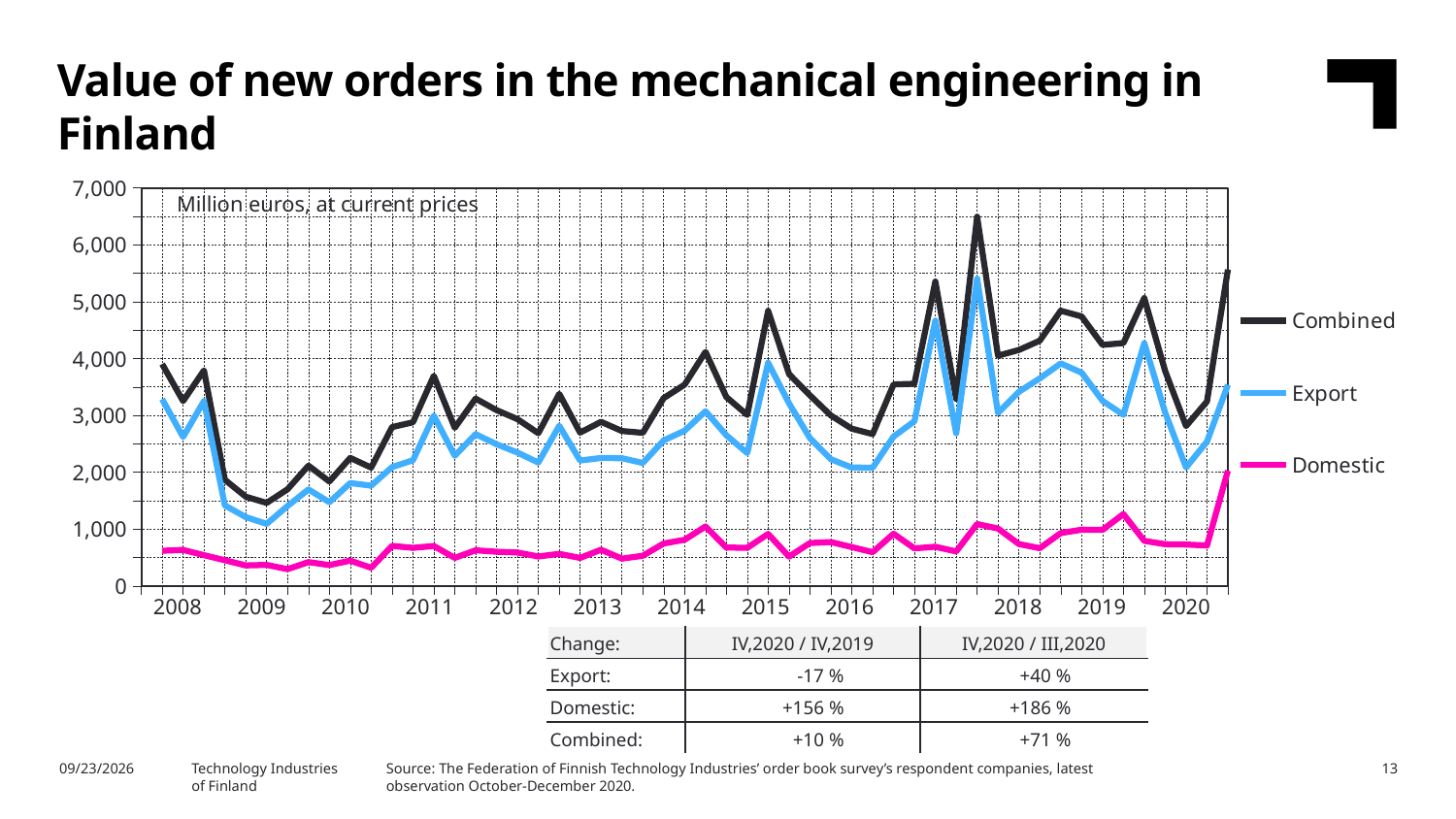
How many year labels are shown on the x axis? 13 Which series has the highest values throughout the chart? Combined Which series has the lowest values throughout the chart? Domestic Is the value of the Domestic series at the start of 2008 greater or less than 1,000? less Does the Combined series rise or fall from the start of 2008 to 2009? fall What colour is the Export line in the legend? Blue Is the peak value of the Combined series in 2017 greater or less than 6,000? greater Is the lowest value of the Export series in 2009 greater or less than 2,000? less How many series does the legend list? 3 What unit is stated inside the chart area? Million euros, at current prices What kind of chart is shown on the slide? Line chart